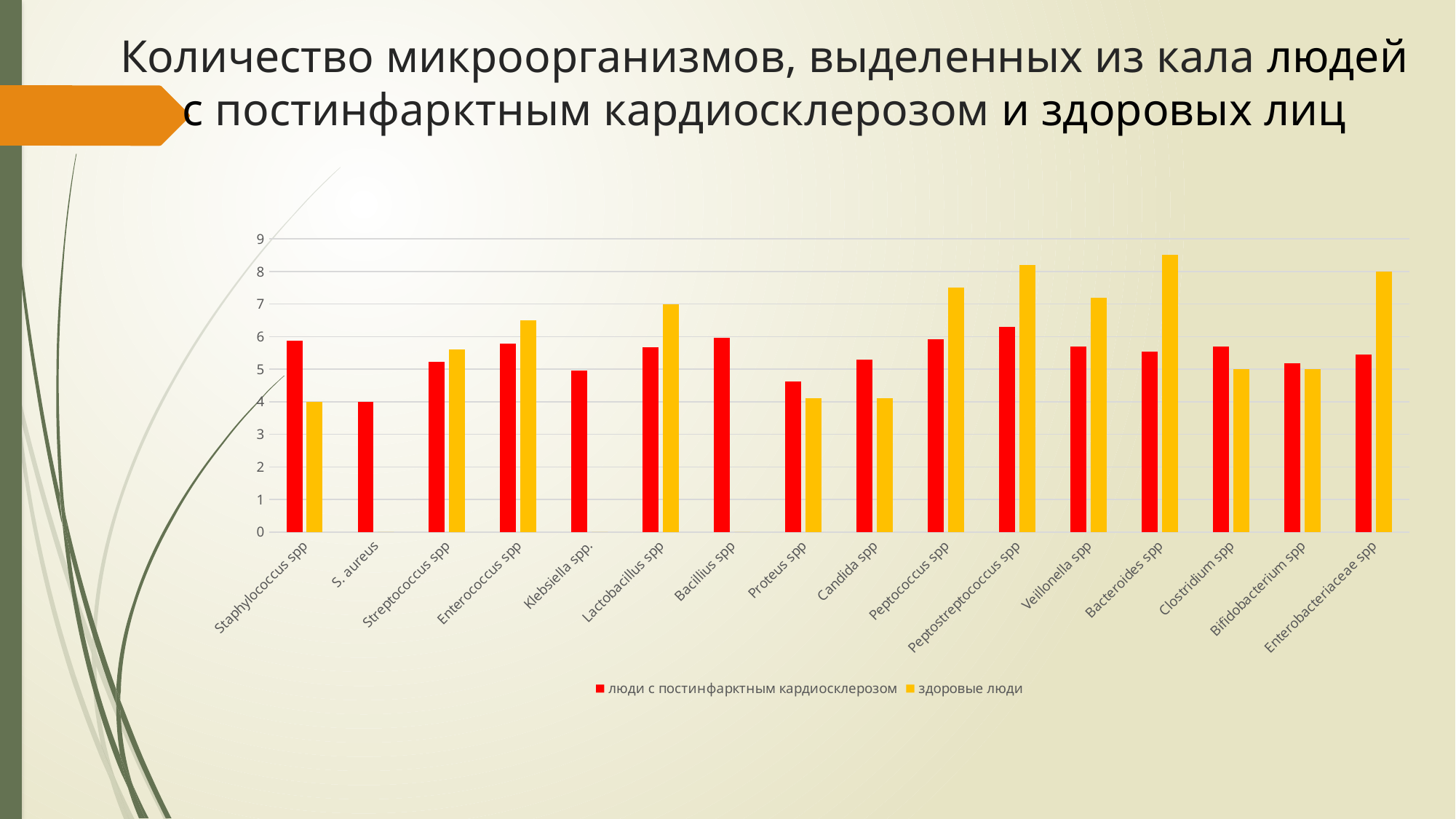
Is the value for люди с постинфарктным кардиосклерозом for Proteus spp greater or less than 5? less What is the value for здоровые люди for Lactobacillus spp? 7 What is the value for здоровые люди for Enterobacteriaceae spp? 8 For Staphylococcus spp, which series has the larger value: люди с постинфарктным кардиосклерозом or здоровые люди? люди с постинфарктным кардиосклерозом How many microorganism categories are shown on the x axis? 16 Is the value for здоровые люди for Bacteroides spp greater or less than 8? greater What is the value for люди с постинфарктным кардиосклерозом for S. aureus? 4 What kind of chart is shown on the slide? bar chart Which category has the highest value for здоровые люди? Bacteroides spp Which category has the lowest value for люди с постинфарктным кардиосклерозом? S. aureus How many series does the legend list? 2 What is the value for здоровые люди for Staphylococcus spp? 4